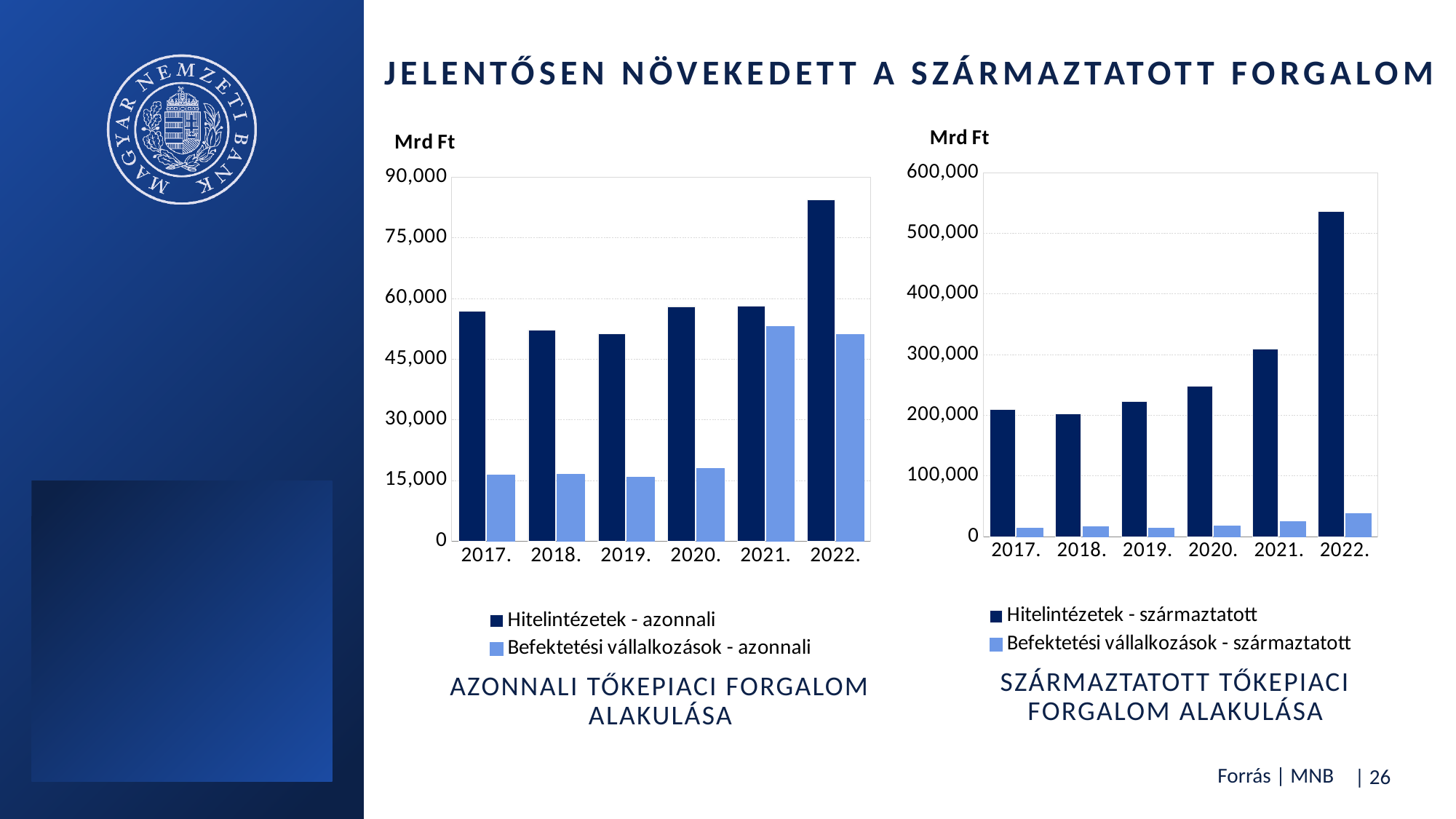
In the right chart, 'Származtatott tőkepiaci forgalom alakulása', which year has the highest value for 'Hitelintézetek - származtatott'? 2022. What unit is shown above the y axis of both charts? Mrd Ft In the right chart, 'Származtatott tőkepiaci forgalom alakulása', do the values for 'Hitelintézetek - származtatott' generally rise or fall from 2018 to 2022? rise In the left chart, 'Azonnali tőkepiaci forgalom alakulása', which year has the highest value for 'Hitelintézetek - azonnali'? 2022. How many years are shown on the x axis of the 'Származtatott tőkepiaci forgalom alakulása' chart on the right? 6 In the right chart, 'Származtatott tőkepiaci forgalom alakulása', which is larger in 2021: 'Hitelintézetek - származtatott' or 'Befektetési vállalkozások - származtatott'? Hitelintézetek - származtatott What kind of chart is the 'Azonnali tőkepiaci forgalom alakulása' chart on the left? bar chart In the left chart, 'Azonnali tőkepiaci forgalom alakulása', is the value for 'Befektetési vállalkozások - azonnali' in 2019 greater or less than 30,000? less In the left chart, 'Azonnali tőkepiaci forgalom alakulása', is the value for 'Befektetési vállalkozások - azonnali' in 2021 greater or less than 45,000? greater In the right chart, 'Származtatott tőkepiaci forgalom alakulása', is the value for 'Hitelintézetek - származtatott' in 2022 greater or less than 500,000? greater How many series does the legend of the left chart, 'Azonnali tőkepiaci forgalom alakulása', list? 2 What is the source given at the bottom of the slide? MNB